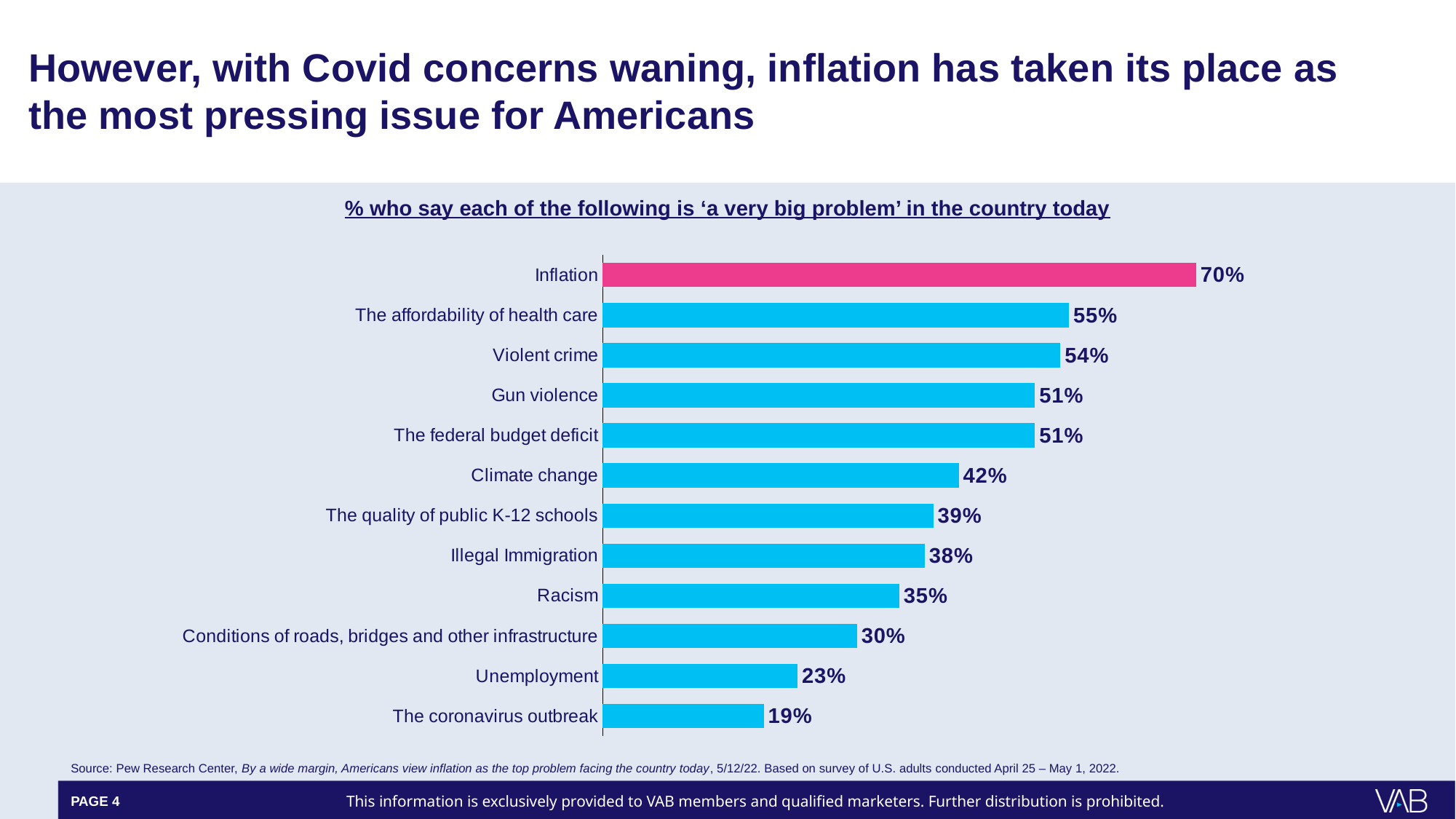
How many categories are shown in the chart? 12 What is the value for The coronavirus outbreak? 19% Which category has the lowest value? The coronavirus outbreak Which category has the highest value? Inflation What percentage of Americans say inflation is a very big problem? 70% What is the difference between the values for Inflation and The coronavirus outbreak? 51 percentage points Which bar is shown in a different colour from the others? Inflation What is the difference between the values for The affordability of health care and Unemployment? 32 percentage points What percentage say Climate change is a very big problem? 42% Which is larger, the value for Racism or the value for Unemployment? Racism What kind of chart is shown on the slide? Bar chart What is the title of the chart? % who say each of the following is 'a very big problem' in the country today